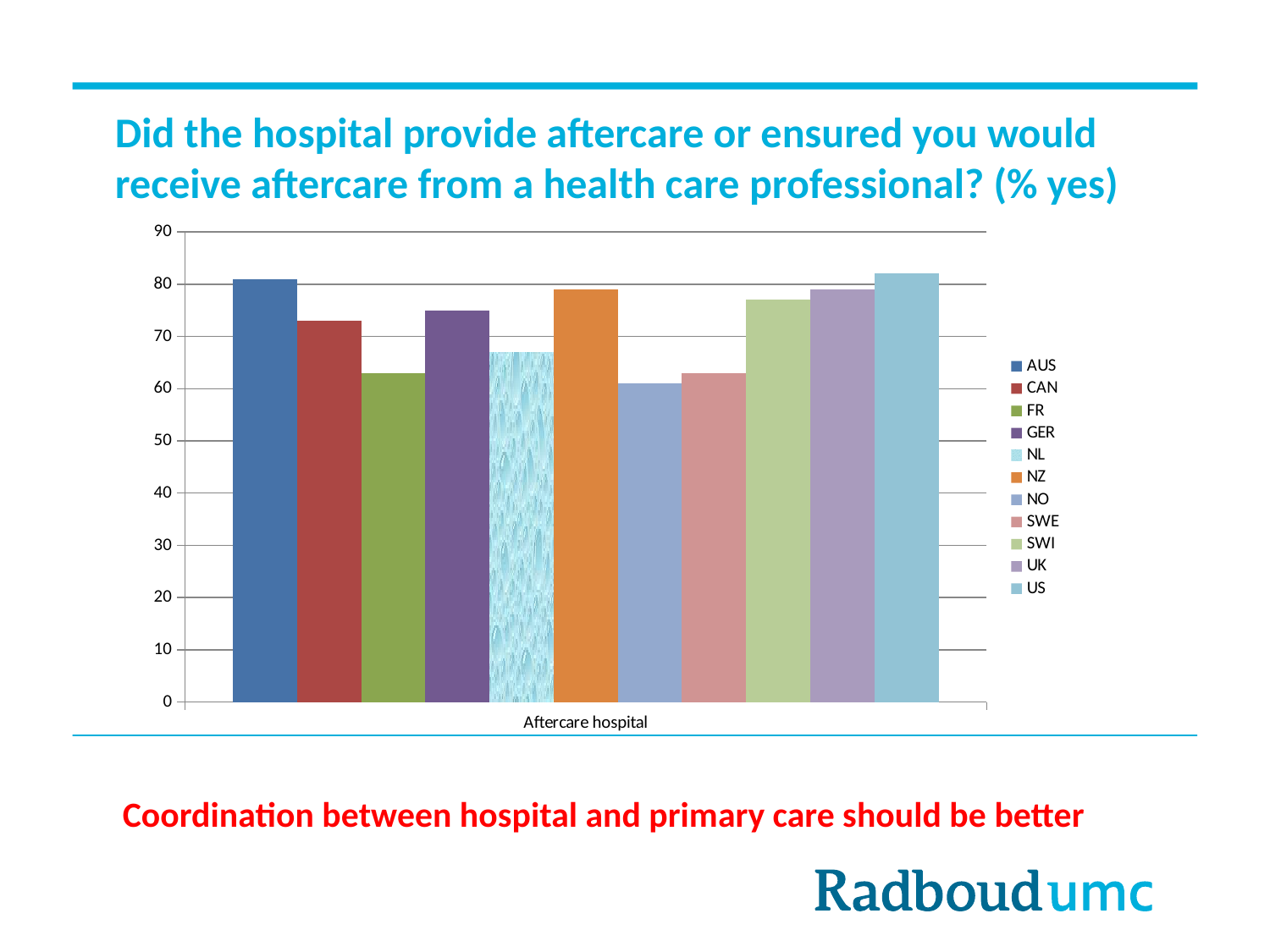
Is the value for FR greater or less than 70? less Is the value for US greater or less than 70? greater Is the value for AUS greater or less than 70? greater How many series does the legend list? 11 Which has the larger value, NZ or NO? NZ Which has the larger value, AUS or FR? AUS What kind of chart is shown on the slide? bar chart How many bars are plotted in the chart? 11 What is the label shown on the x axis of the chart? Aftercare hospital Which has the larger value, SWI or SWE? SWI